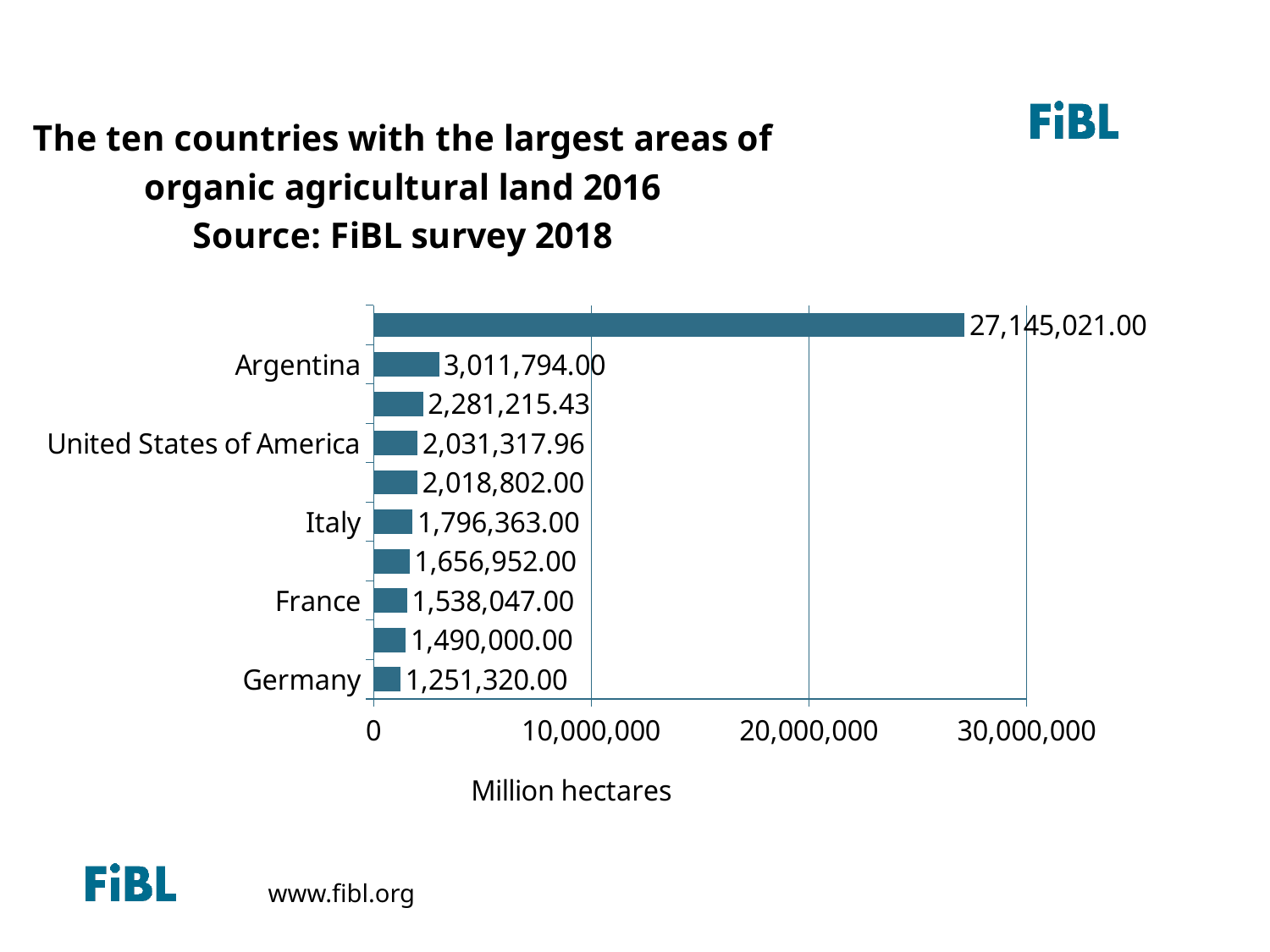
What kind of chart is shown on the slide? bar chart What is the value for Germany? 1,251,320.00 How many bars are shown in the chart? 10 What is the difference between the values for Argentina and Germany? 1,760,474.00 Which labelled country has the lowest value? Germany Which is larger, the value for Argentina or the value for Italy? Argentina What is the value for United States of America? 2,031,317.96 Is the value for Argentina greater or less than 10,000,000? less What is the value for Argentina? 3,011,794.00 What is the difference between the values for Italy and France? 258,316.00 What is the value for Italy? 1,796,363.00 What is the value for France? 1,538,047.00